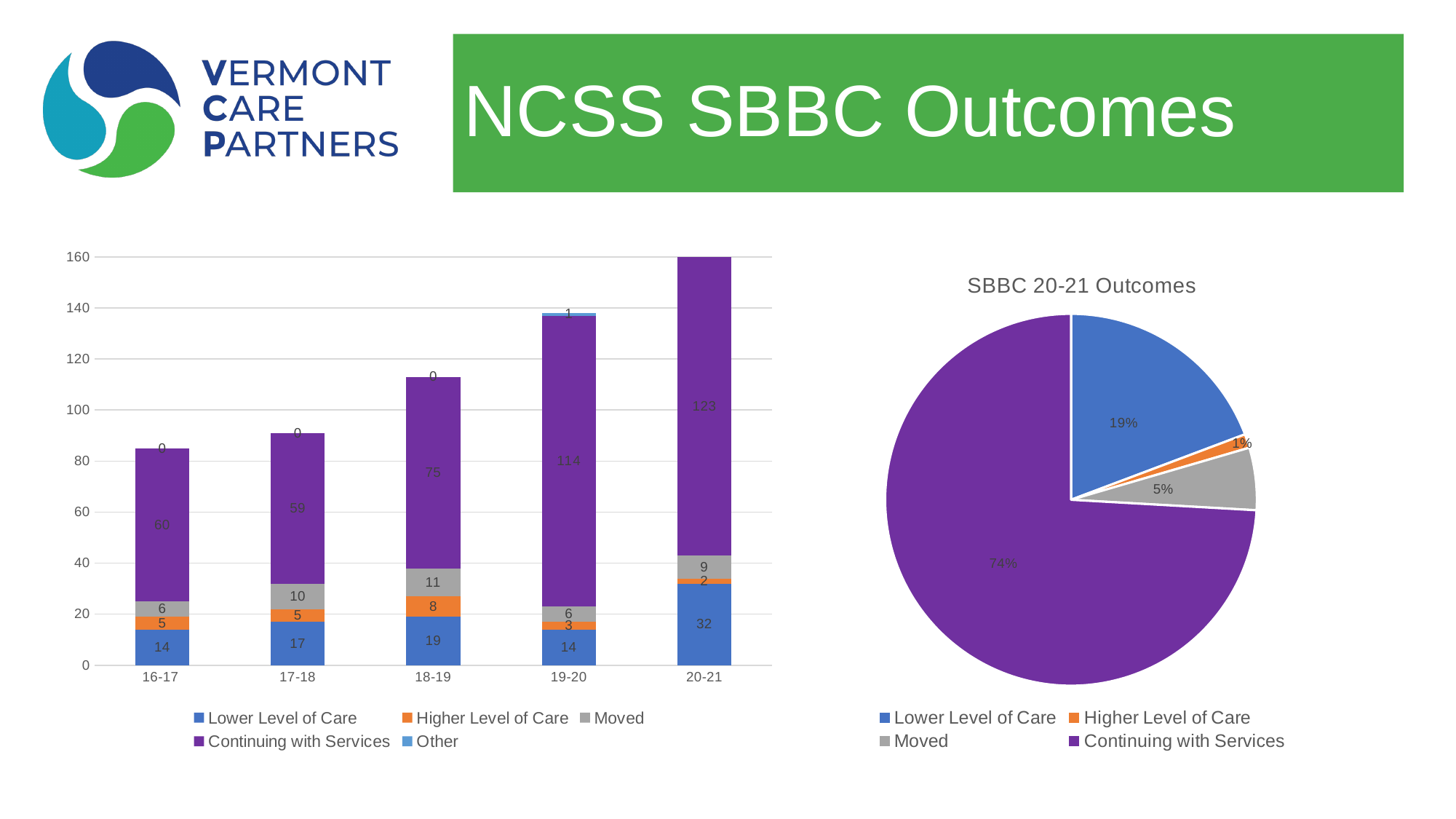
In the left bar chart, what is the value for Continuing with Services in 19-20? 114 How many series does the legend of the left bar chart list? 5 In the left bar chart, which is larger: Higher Level of Care in 18-19 or in 17-18? 18-19 What kind of chart is the chart on the left of the slide? bar chart In the left bar chart, what is the value for Lower Level of Care in 20-21? 32 In the left bar chart, what is the total of the stacked bar for 16-17? 85 In the SBBC 20-21 Outcomes pie chart, what share does Continuing with Services have? 74% In the left bar chart, which year has the highest value for Continuing with Services? 20-21 How many year categories are shown on the x axis of the left bar chart? 5 In the SBBC 20-21 Outcomes pie chart, which category has the smallest slice? Higher Level of Care In the left bar chart, what is the difference between the Moved values for 18-19 and 16-17? 5 In the left bar chart, do the total bar heights rise or fall from 16-17 to 20-21? rise